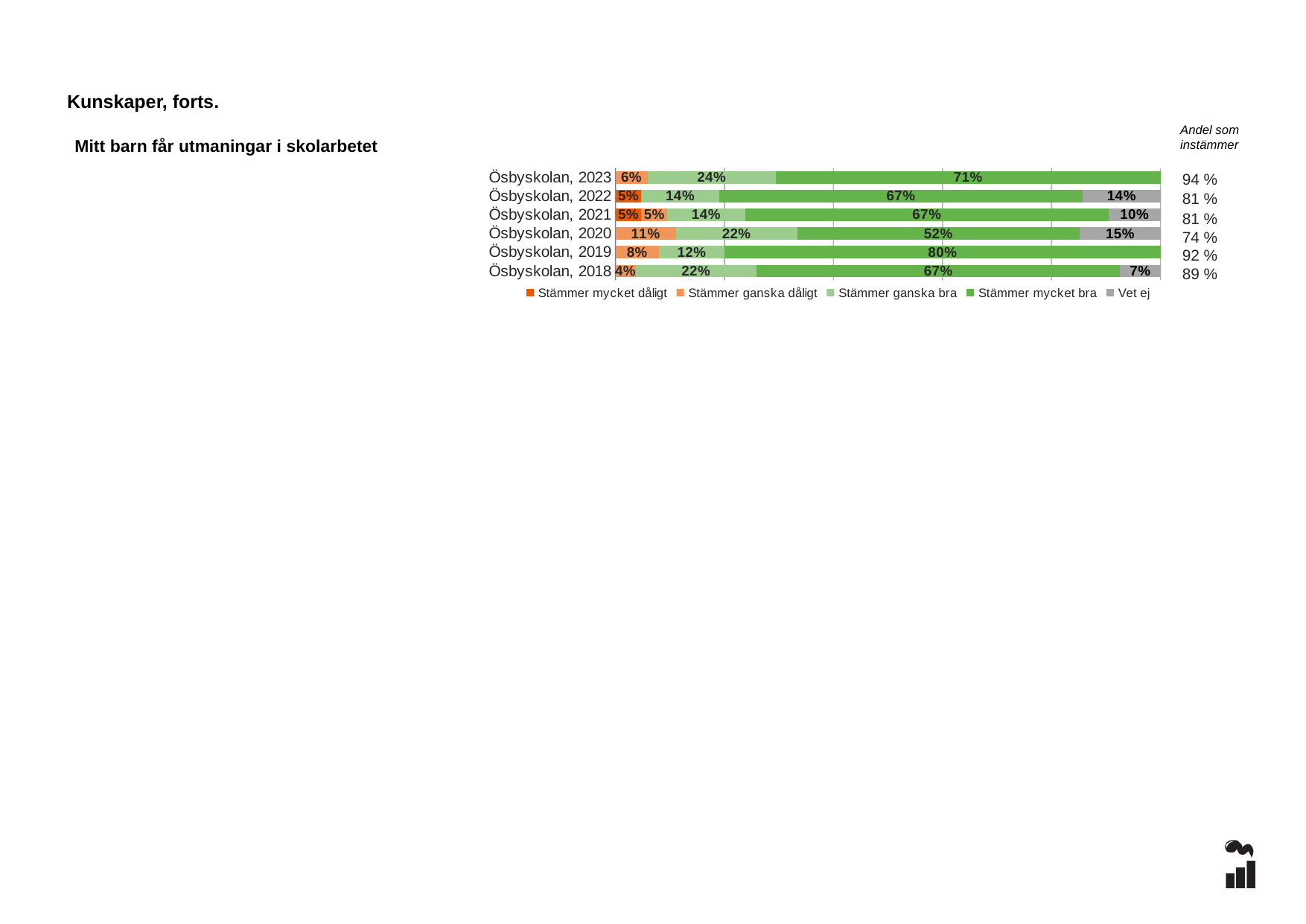
What is the value for "Stämmer mycket bra" for Ösbyskolan, 2023? 71% Which category has the lowest value for "Stämmer mycket bra"? Ösbyskolan, 2020 What is the value for "Vet ej" for Ösbyskolan, 2022? 14% Which has the larger "Stämmer ganska bra" value, Ösbyskolan, 2023 or Ösbyskolan, 2018? Ösbyskolan, 2023 What is the "Andel som instämmer" value shown for Ösbyskolan, 2020? 74 % How many series does the legend list? 5 What is the value for "Stämmer ganska dåligt" for Ösbyskolan, 2019? 8% How many categories (bars) are shown in the chart? 6 What kind of chart is shown on the slide? Stacked bar chart Which category has the highest value for "Stämmer mycket bra"? Ösbyskolan, 2019 What is the difference between the "Stämmer mycket bra" values for Ösbyskolan, 2019 and Ösbyskolan, 2020? 28 percentage points What is the value for "Stämmer ganska bra" for Ösbyskolan, 2020? 22%